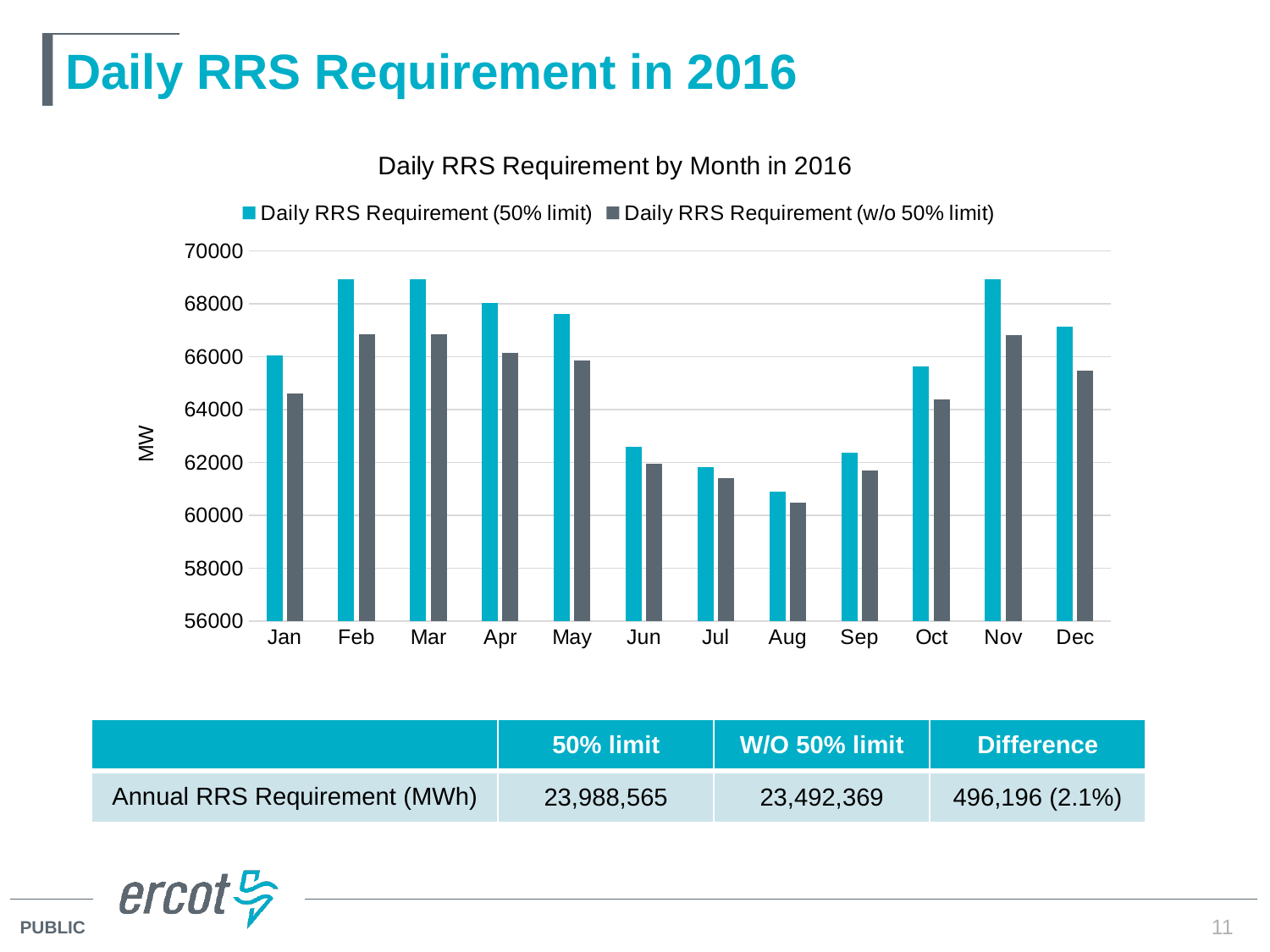
Does the Daily RRS Requirement (50% limit) rise or fall from Mar to Aug? fall How many months are shown on the x axis of the chart? 12 How many series does the chart legend list? 2 Is the Daily RRS Requirement (50% limit) for Jan greater or less than 64000? greater What is the label on the y axis of the chart? MW Is the Daily RRS Requirement (50% limit) for Aug greater or less than 62000? less Is the Daily RRS Requirement (w/o 50% limit) for Nov greater or less than 66000? greater What kind of chart is shown on the slide? bar chart Which month has the lowest Daily RRS Requirement (w/o 50% limit)? Aug Which month has the lowest Daily RRS Requirement (50% limit)? Aug In Jan, which is larger: the Daily RRS Requirement (50% limit) or the Daily RRS Requirement (w/o 50% limit)? Daily RRS Requirement (50% limit)